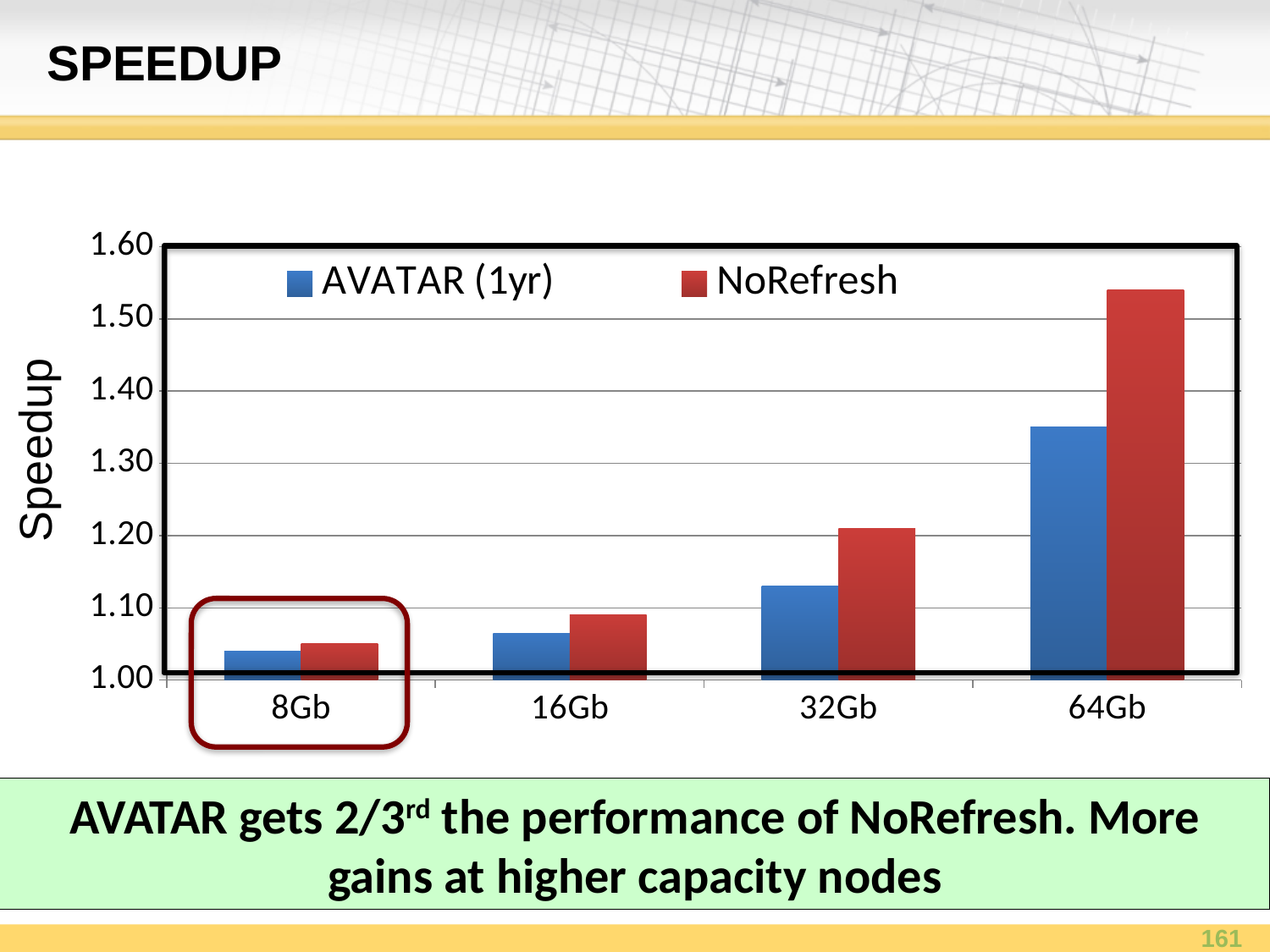
How many series does the legend list? 2 Which capacity has the highest NoRefresh speedup? 64Gb Is the NoRefresh speedup at 32Gb greater or less than 1.30? less What is the label on the y axis of the chart? Speedup Is the NoRefresh speedup at 64Gb greater or less than 1.50? greater Do the NoRefresh speedup values rise or fall as capacity increases from 8Gb to 64Gb? rise How many capacity categories are shown on the x axis? 4 What kind of chart is shown on the slide? bar chart Is the AVATAR (1yr) speedup at 16Gb greater or less than 1.10? less At 64Gb, which series has the larger speedup, AVATAR (1yr) or NoRefresh? NoRefresh Which capacity has the lowest AVATAR (1yr) speedup? 8Gb